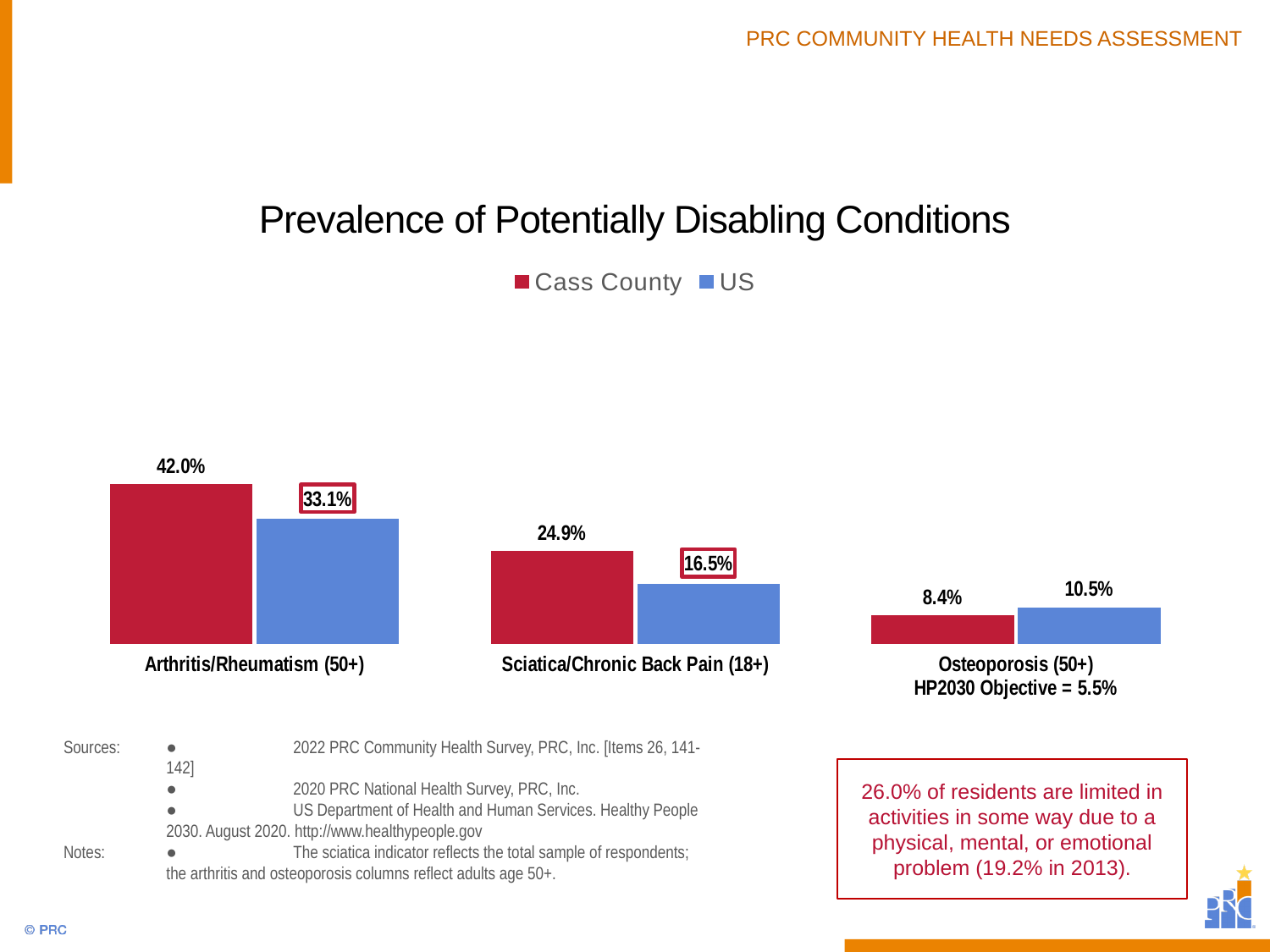
For Osteoporosis (50+), which is larger: the Cass County value or the US value? US How many series does the legend list? 2 What is the US value for Arthritis/Rheumatism (50+)? 33.1% Which condition has the highest Cass County value? Arthritis/Rheumatism (50+) How many conditions are shown on the chart? 3 What is the Cass County value for Arthritis/Rheumatism (50+)? 42.0% What is the difference between the Cass County and US values for Sciatica/Chronic Back Pain (18+)? 8.4% What is the US value for Sciatica/Chronic Back Pain (18+)? 16.5% What is the Cass County value for Osteoporosis (50+)? 8.4% What is the difference between the Cass County and US values for Arthritis/Rheumatism (50+)? 8.9% Which condition has the lowest US value? Osteoporosis (50+) What kind of chart is shown on the slide? Bar chart